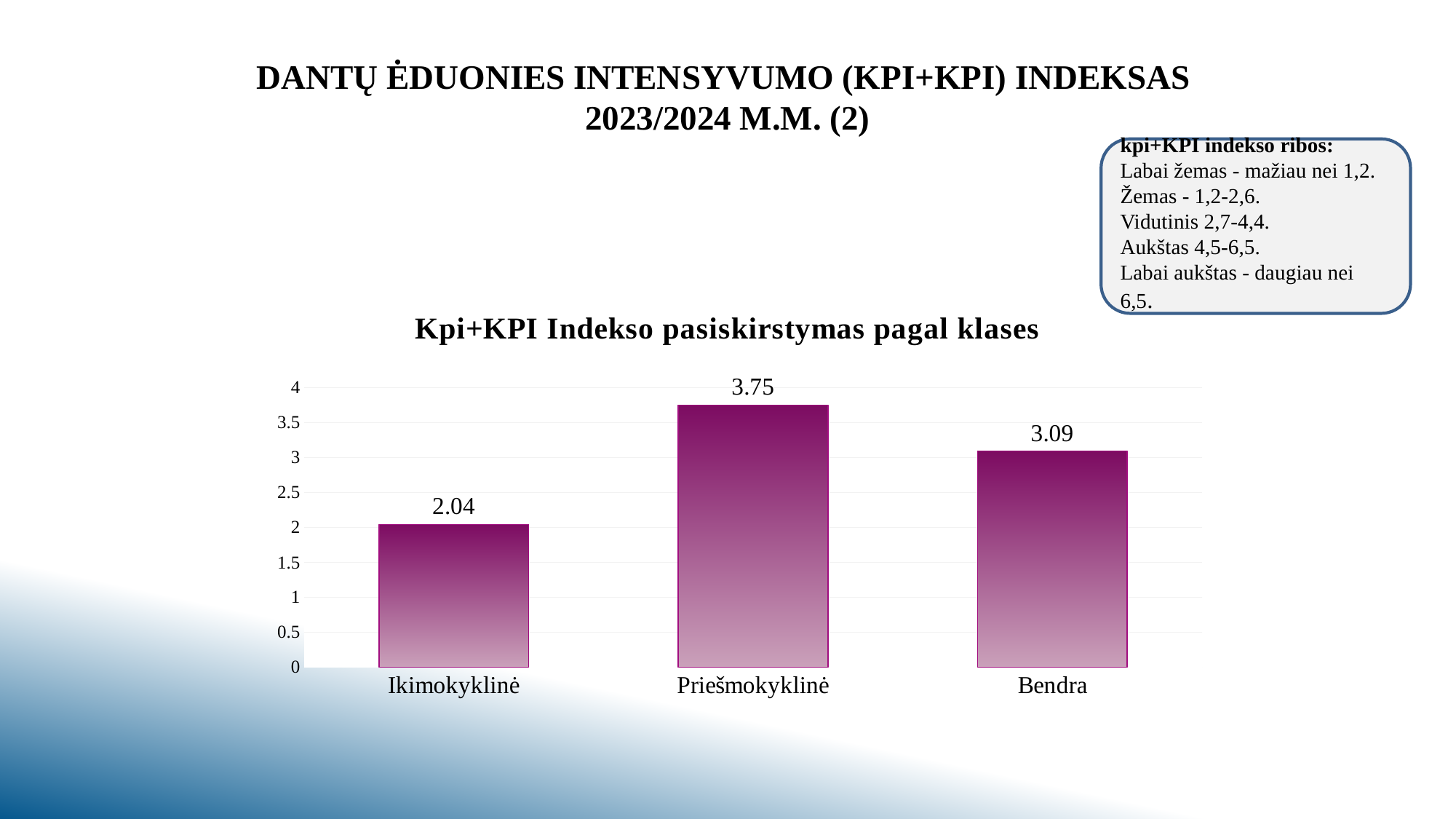
What is the difference between the values for Priešmokyklinė and Ikimokyklinė? 1.71 What is the title of the chart? Kpi+KPI Indekso pasiskirstymas pagal klases Which category has the lowest value? Ikimokyklinė What is the difference between the values for Priešmokyklinė and Bendra? 0.66 What kind of chart is shown on the slide? bar chart Which is larger, the value for Bendra or the value for Ikimokyklinė? Bendra Which category has the highest value? Priešmokyklinė What is the value for Priešmokyklinė? 3.75 What is the value for Bendra? 3.09 Is the value for Ikimokyklinė greater or less than 2.5? less How many categories are shown on the x axis? 3 What is the value for Ikimokyklinė? 2.04